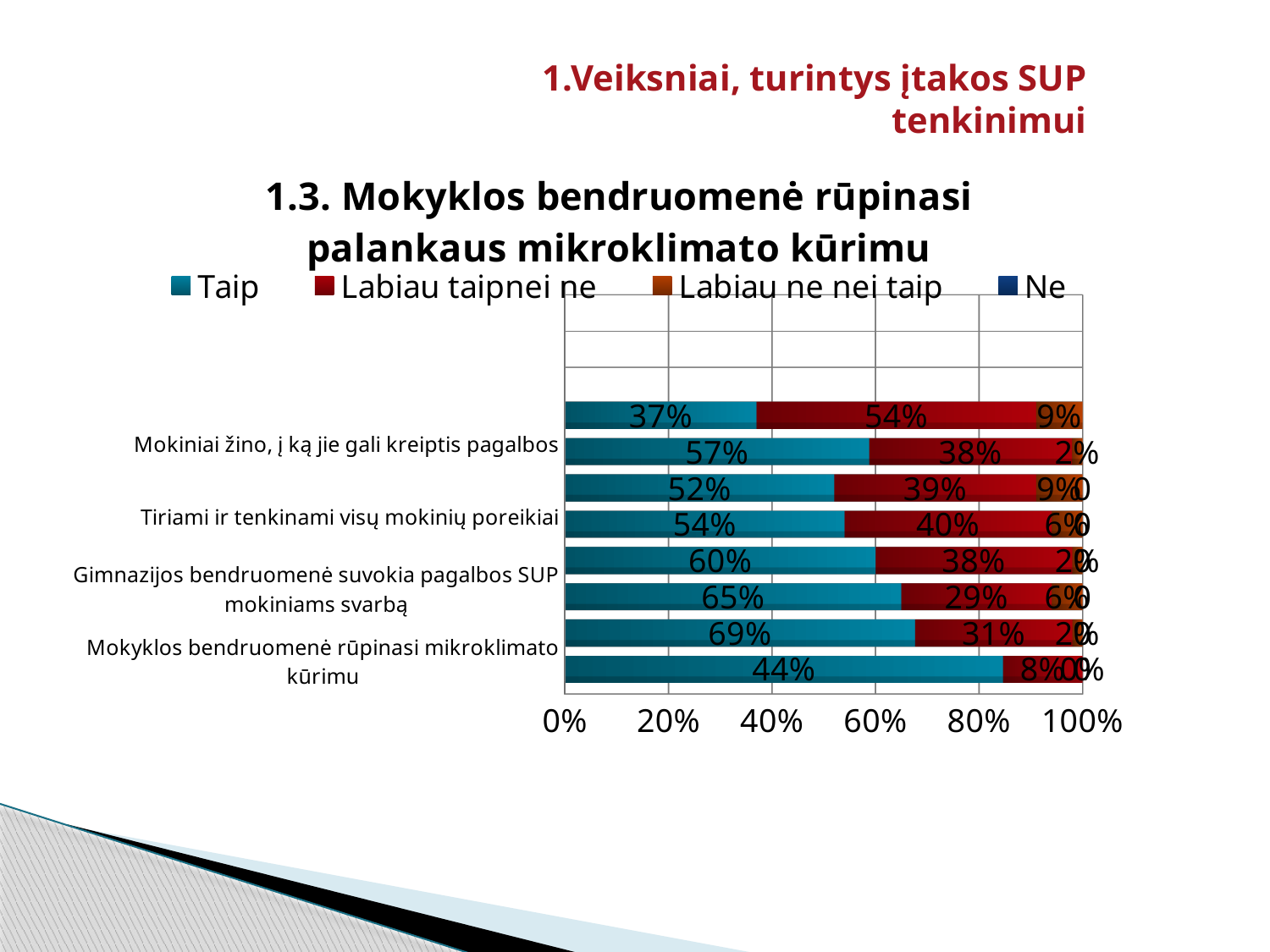
On the topmost bar, which is larger: the Taip segment or the Labiau taip nei ne segment? Labiau taip nei ne What is the Labiau taip nei ne value printed on the topmost bar? 54% What is the chart's title? 1.3. Mokyklos bendruomenė rūpinasi palankaus mikroklimato kūrimu What is the Taip value printed on the second bar from the top? 57% What are the four legend entries of the chart? Taip, Labiau taipnei ne, Labiau ne nei taip, Ne What is the Taip value printed on the topmost bar? 37% What is the Labiau ne nei taip value printed on the topmost bar? 9% What kind of chart is shown on the slide? Stacked bar chart How many bars are plotted in the chart? 8 What is the highest Taip value printed on the chart? 69% How many series does the chart legend list? 4 On the topmost bar, by how many percentage points does the Labiau taip nei ne value exceed the Taip value? 17 percentage points